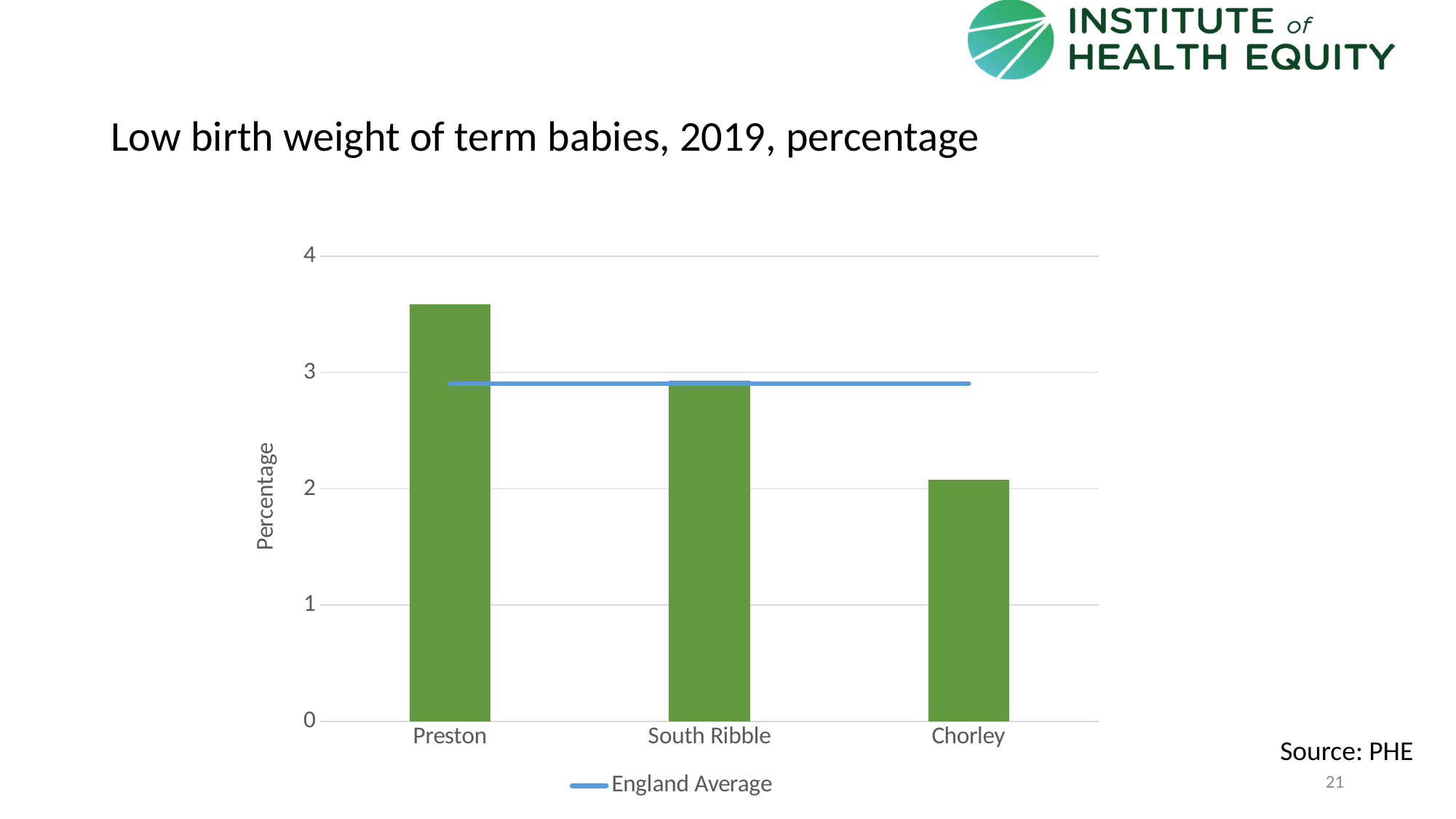
Which area has the lowest percentage of low birth weight term babies? Chorley Which has the larger value, Preston or South Ribble? Preston What is the title of the chart? Low birth weight of term babies, 2019, percentage What does the blue horizontal line on the chart represent, according to the legend? England Average Do the bar values rise or fall from left to right across the x axis? Fall How many areas (bars) are plotted on the chart? 3 What kind of chart is shown on the slide? Bar chart Is the value for Chorley greater or less than 3? less Which has the larger value, Preston or Chorley? Preston Which area has the highest percentage of low birth weight term babies? Preston Is the value for South Ribble greater or less than 2? greater Is the value for Preston greater or less than 3? greater